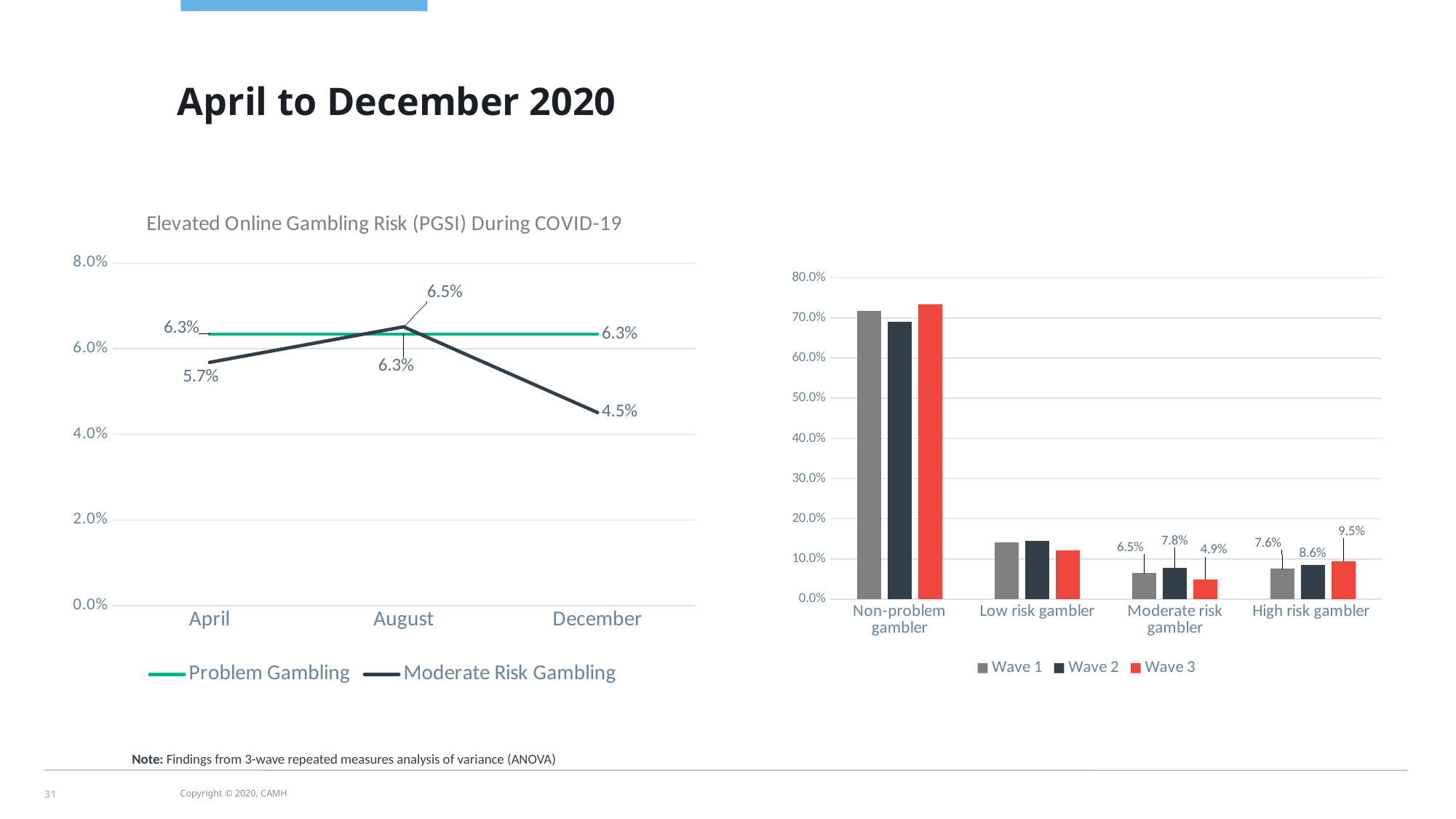
In the left chart, what is the Moderate Risk Gambling value for December? 4.5% What type of chart is the chart on the left? line chart In the left chart, what is the difference between the Moderate Risk Gambling values for August and December? 2.0% In the left chart, what is the Moderate Risk Gambling value for August? 6.5% In the left chart, what is the Problem Gambling value for April? 6.3% In the right chart, which wave has the highest value for High risk gambler? Wave 3 In the right chart, how many categories are shown on the x axis? 4 In the left chart, how many series does the legend list? 2 In the right chart, is the Wave 1 value for Non-problem gambler greater or less than 60.0%? greater In the left chart, in which month is Moderate Risk Gambling lowest? December In the right chart, what is the Wave 1 value for Moderate risk gambler? 6.5% In the right chart, what is the Wave 3 value for High risk gambler? 9.5%